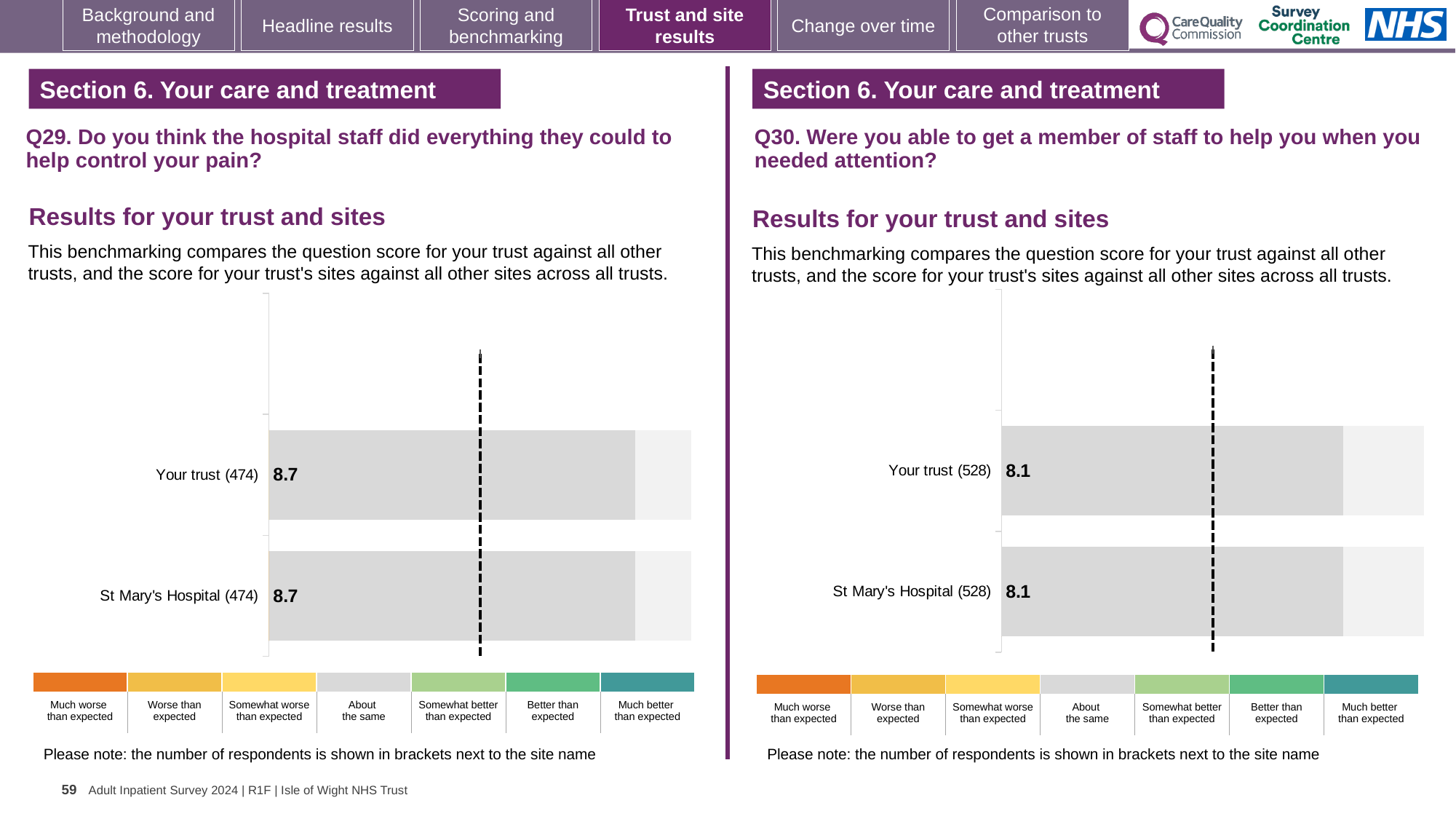
How many bars are plotted on the Q29 chart (left)? 2 On the Q30 chart (right), what is the score for St Mary's Hospital? 8.1 On the Q29 chart (left), what is the difference between the scores for Your trust and St Mary's Hospital? 0 How many bars are plotted on the Q30 chart (right)? 2 What kind of chart is used on the Q30 chart (right)? Bar chart On the Q29 chart (left), what is the score for Your trust? 8.7 On the Q30 chart (right), what is the score for Your trust? 8.1 On the Q30 chart (right), how many respondents are shown in brackets for St Mary's Hospital? 528 On the Q29 chart (left), how many respondents are shown in brackets for Your trust? 474 On the Q30 chart (right), what is the difference between the scores for Your trust and St Mary's Hospital? 0 On the Q29 chart (left), what is the score for St Mary's Hospital? 8.7 On the Q29 chart (left), how many benchmark categories are shown in the colour key below the chart? 7